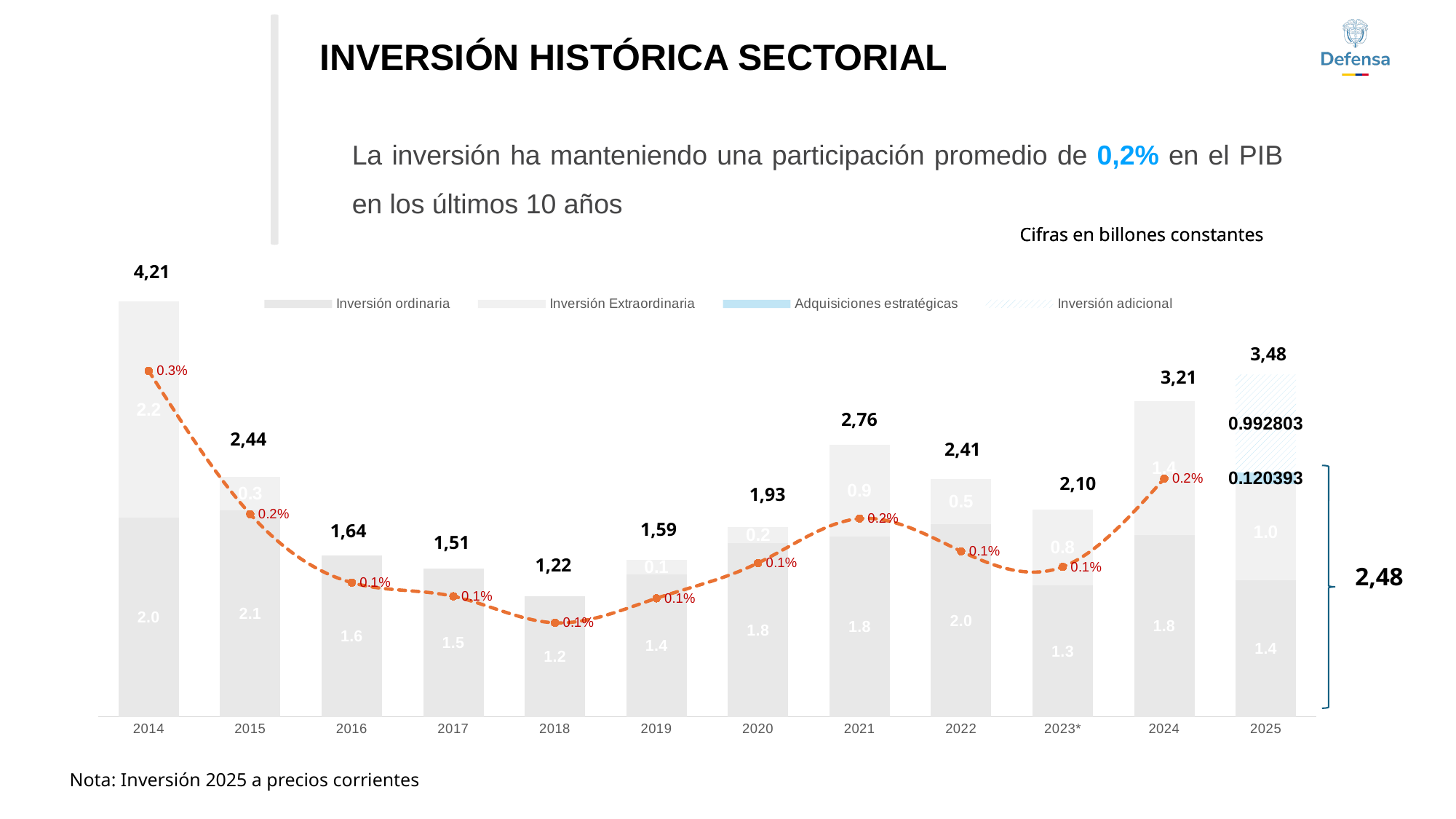
How many series does the chart legend list? 4 Which year has the lowest total investment? 2018 How many years are shown on the x axis of the chart? 12 What kind of chart is used to show the investment by year? Stacked bar chart with a dashed line What is the total investment value labeled above the bar for 2014? 4,21 Which year has the highest total investment? 2014 What is the total investment value labeled above the bar for 2021? 2,76 What percentage of GDP does the dashed line show for 2014? 0.3% What is the difference between the total investment in 2014 (4,21) and in 2018 (1,22)? 2,99 What is the Inversión ordinaria value labeled inside the bar for 2015? 2.1 Do the total investment values rise or fall from 2014 to 2018? Fall Which year has a larger total investment, 2024 or 2025? 2025